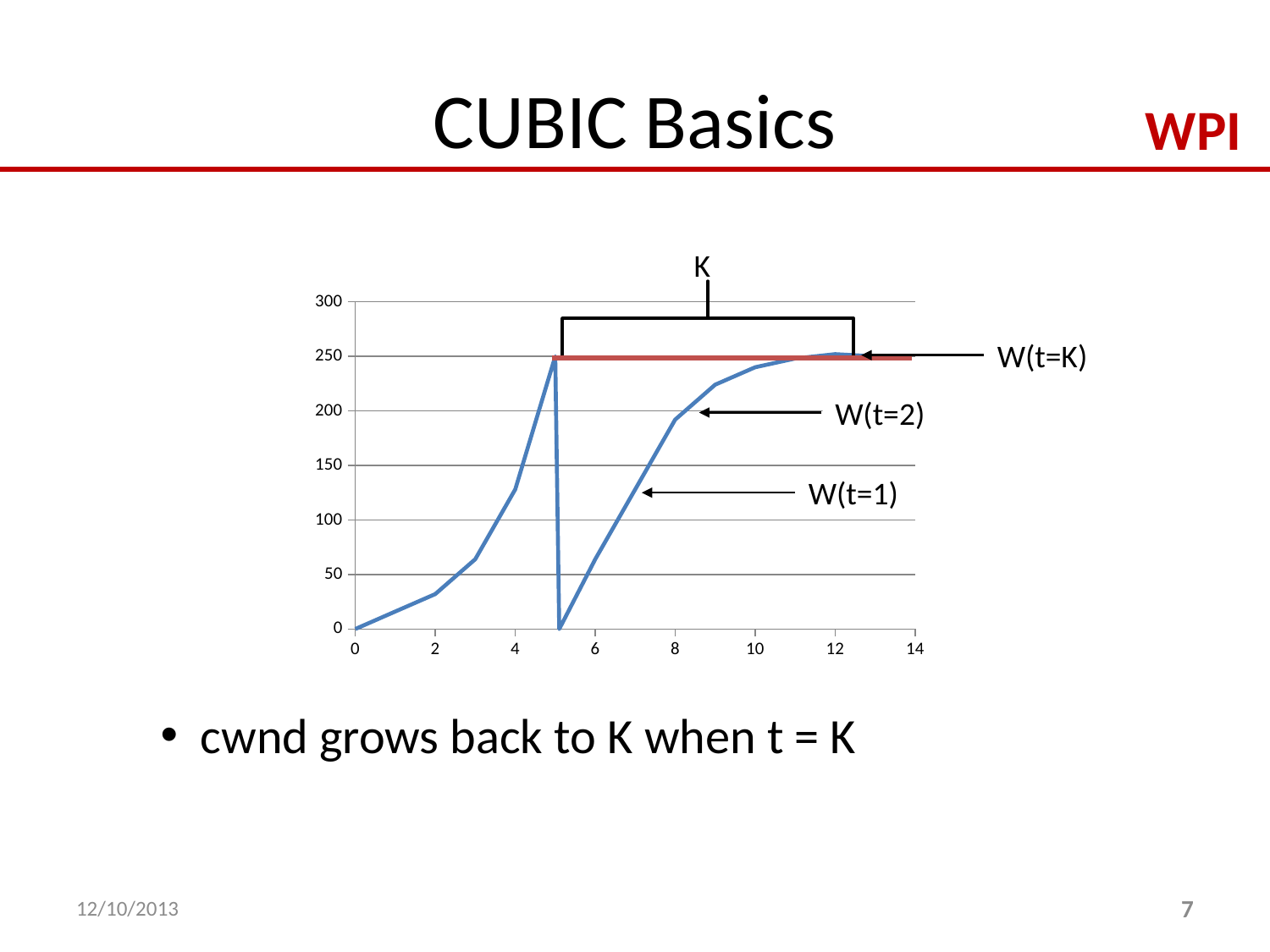
What is the highest value shown on the vertical axis? 300 What kind of chart is shown on the slide? line chart Is the value of the blue line at x = 4 greater or less than 100? greater Is the value of the blue line at x = 10 greater or less than 200? greater Is the value of the blue line at x = 4 greater or less than 150? less What label is attached to the arrow pointing at the red horizontal line? W(t=K) Does the blue line rise or fall between x = 6 and x = 12? rise What is the value of the blue line at x = 0? 0 Does the blue line rise or fall between x = 0 and x = 4? rise